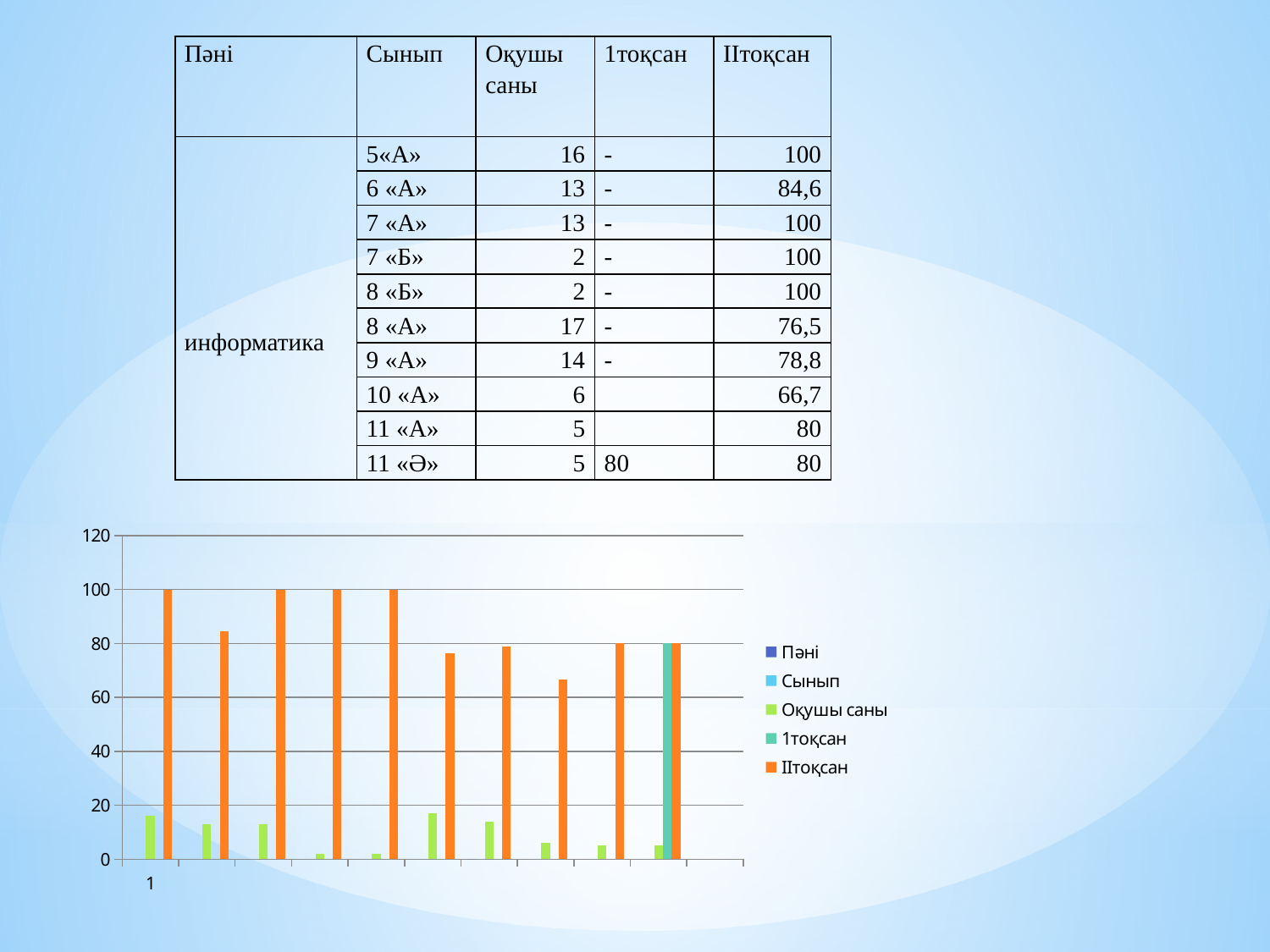
Which is taller: the green Оқушы саны bar in the first group or the green Оқушы саны bar in the fourth group? the first group How many series does the chart legend list? 5 What value does the orange IIтоқсан bar in the first group reach on the axis? 100 What kind of chart is shown on the slide? bar chart In the first group, which bar is taller: the green Оқушы саны bar or the orange IIтоқсан bar? the orange IIтоқсан bar Which group has the lowest orange IIтоқсан bar? the eighth group What colour does the legend assign to the IIтоқсан series? orange Is the green Оқушы саны bar in the first group greater or less than 20? less Is the orange IIтоқсан bar in the eighth group greater or less than 80? less Which series in the legend has a visible bar in only one group of the chart? 1тоқсан What value does the orange IIтоқсан bar in the last (tenth) group reach on the axis? 80 How many groups of bars are plotted along the x axis of the chart? 10